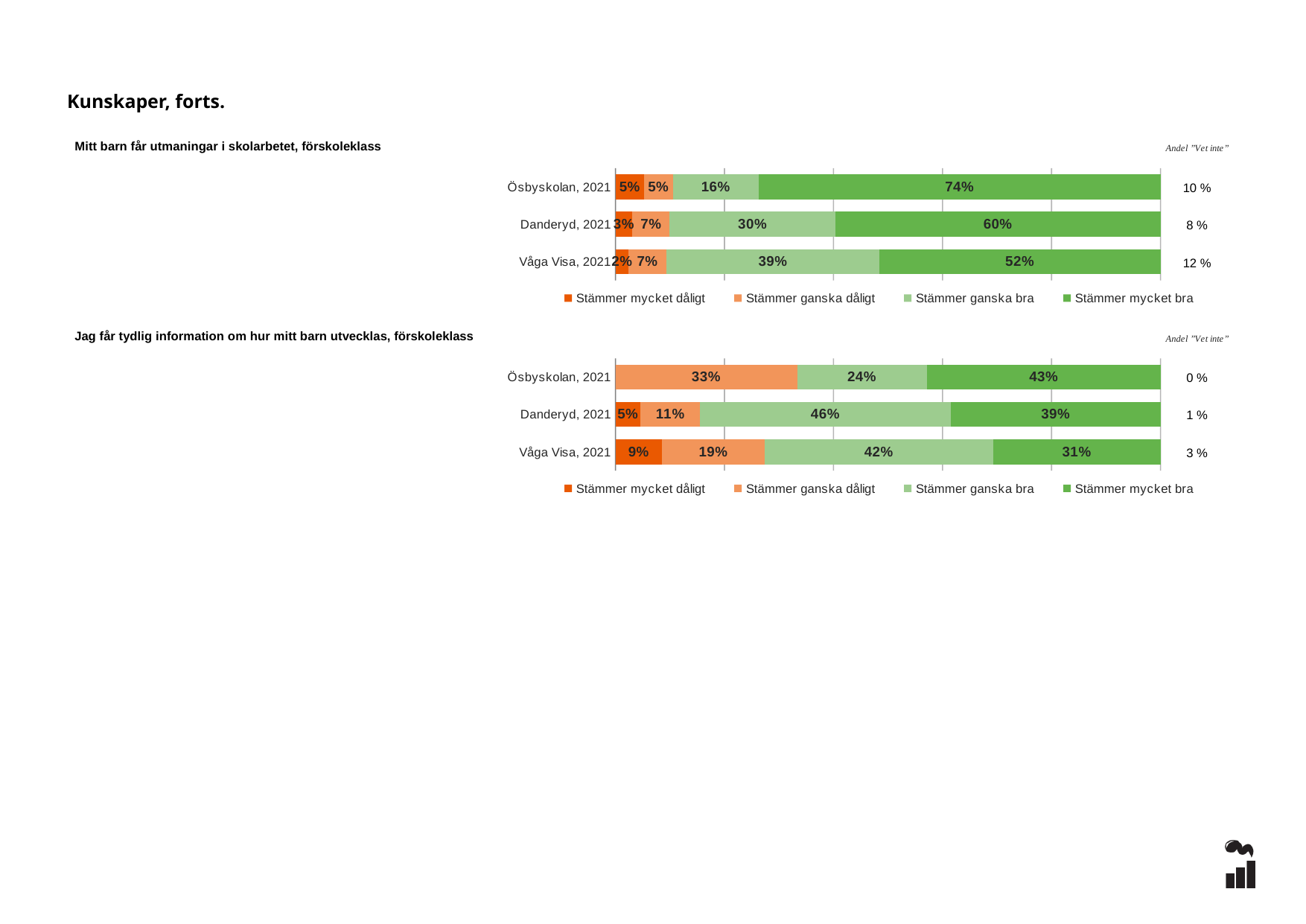
In the chart 'Jag får tydlig information om hur mitt barn utvecklas, förskoleklass', which category has the lowest value for 'Stämmer mycket bra'? Våga Visa, 2021 In the chart 'Jag får tydlig information om hur mitt barn utvecklas, förskoleklass', what is the value of 'Stämmer ganska dåligt' for Ösbyskolan, 2021? 33% In the chart 'Mitt barn får utmaningar i skolarbetet, förskoleklass', what is the value of 'Stämmer ganska bra' for Våga Visa, 2021? 39% What kind of chart is 'Jag får tydlig information om hur mitt barn utvecklas, förskoleklass'? Stacked bar chart In the chart 'Mitt barn får utmaningar i skolarbetet, förskoleklass', what is the difference between the 'Stämmer mycket bra' values for Danderyd, 2021 and Våga Visa, 2021? 8% In the chart 'Mitt barn får utmaningar i skolarbetet, förskoleklass', what is the value of 'Stämmer mycket bra' for Ösbyskolan, 2021? 74% In the chart 'Mitt barn får utmaningar i skolarbetet, förskoleklass', what is the 'Andel Vet inte' value for Våga Visa, 2021? 12 % In the chart 'Jag får tydlig information om hur mitt barn utvecklas, förskoleklass', what is the difference between 'Stämmer mycket dåligt' for Våga Visa, 2021 and Danderyd, 2021? 4% In the chart 'Jag får tydlig information om hur mitt barn utvecklas, förskoleklass', which is larger: 'Stämmer ganska bra' for Danderyd, 2021 or for Våga Visa, 2021? Danderyd, 2021 How many series does the legend list in the chart 'Mitt barn får utmaningar i skolarbetet, förskoleklass'? 4 In the chart 'Mitt barn får utmaningar i skolarbetet, förskoleklass', which category has the highest value for 'Stämmer mycket bra'? Ösbyskolan, 2021 How many categories are shown in the chart 'Jag får tydlig information om hur mitt barn utvecklas, förskoleklass'? 3